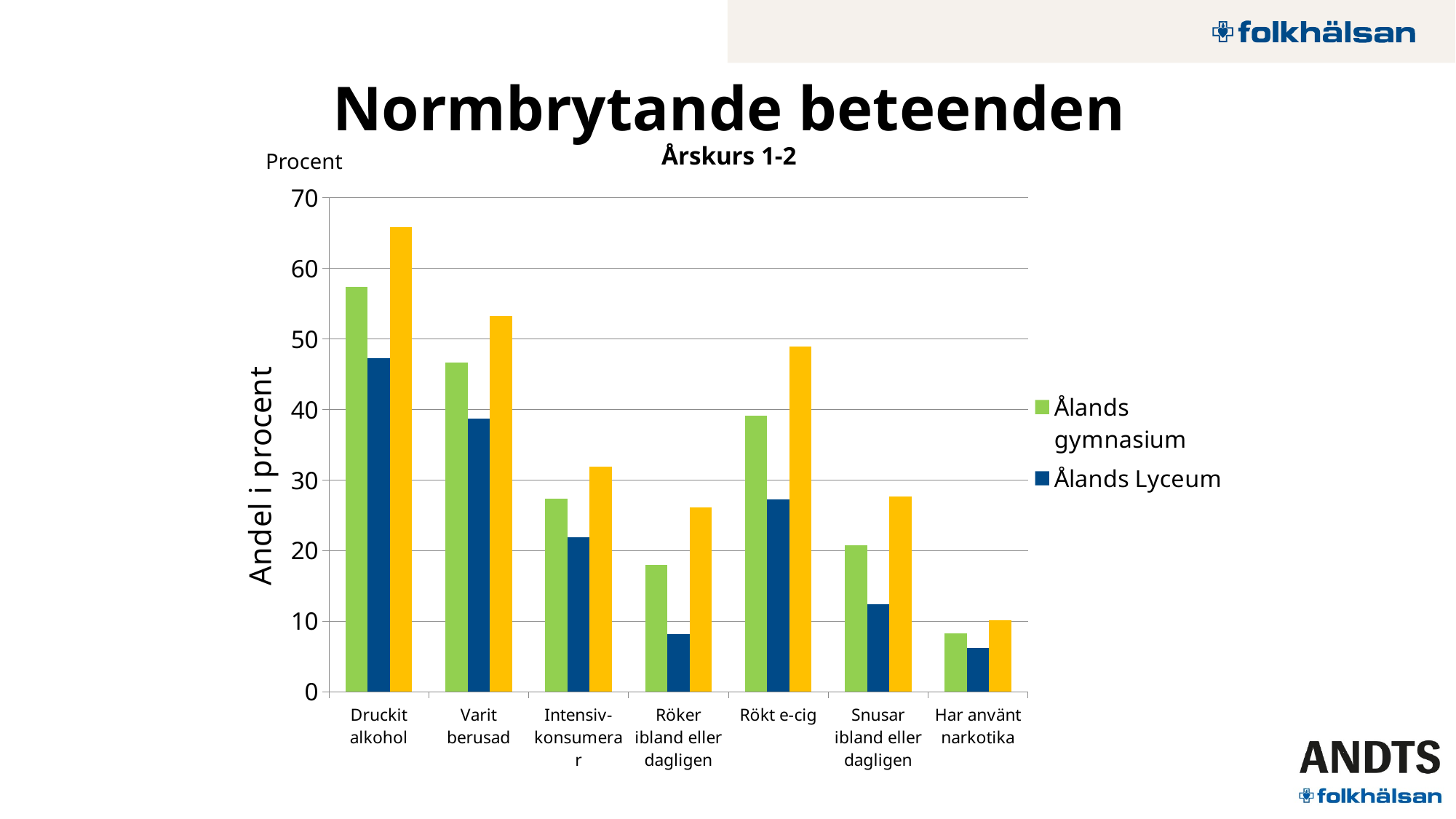
Is the value for Ålands Lyceum in Druckit alkohol greater or less than 50? less What kind of chart is shown on the slide? Bar chart Which category has the lowest value for Ålands Lyceum? Har använt narkotika Is the value for Ålands Lyceum in Röker ibland eller dagligen greater or less than 10? less Which category has the highest value for Ålands gymnasium? Druckit alkohol How many categories are shown on the x axis of the chart? 7 For Druckit alkohol, which is larger: Ålands gymnasium or Ålands Lyceum? Ålands gymnasium What is the label on the chart's vertical axis? Andel i procent What is the title of the chart? Årskurs 1-2 Is the value for Ålands gymnasium in Druckit alkohol greater or less than 50? greater How many series does the chart's legend list? 2